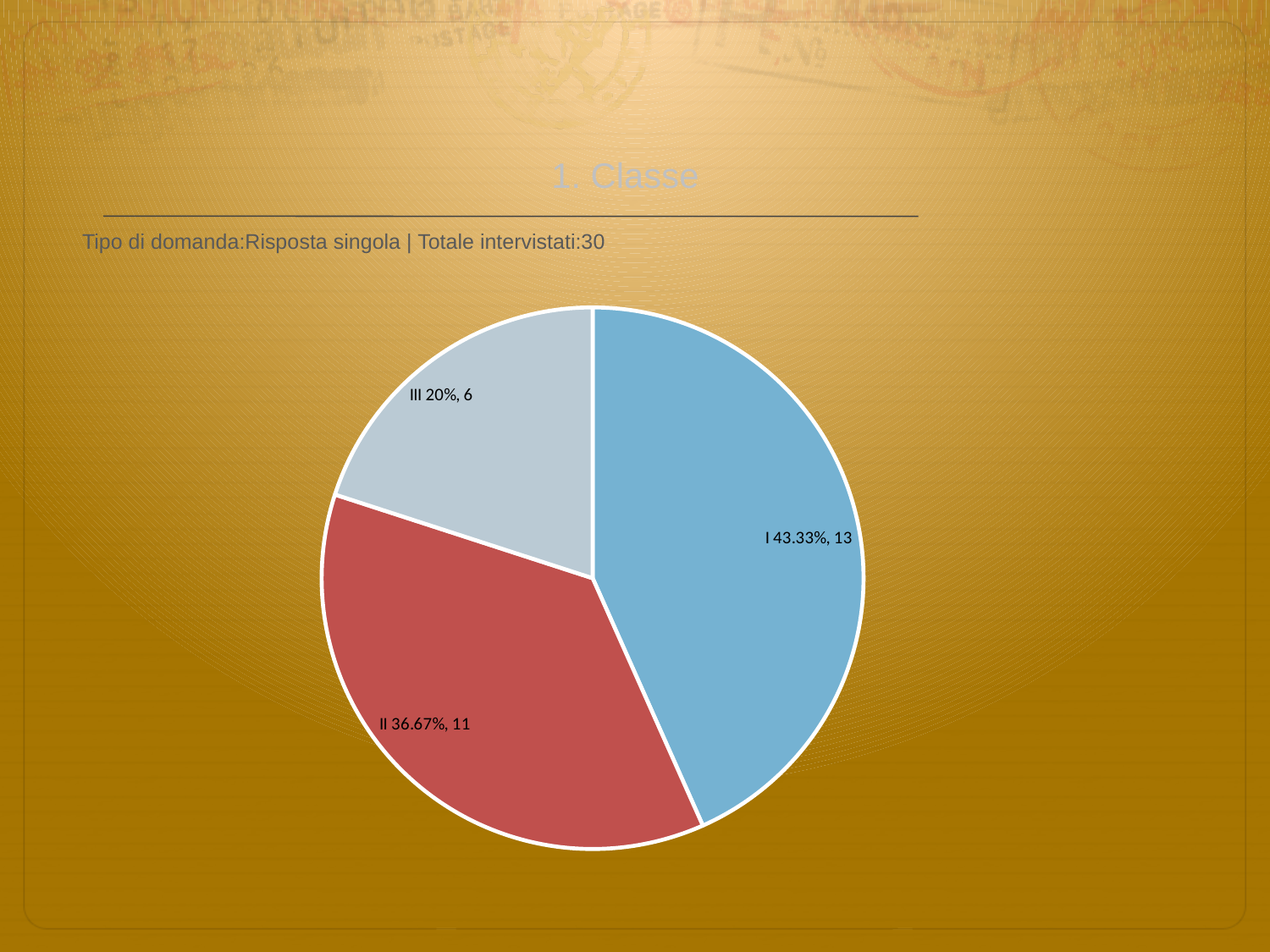
What share of the pie does category I represent? 43.33% What is the count for category I? 13 Which category has the largest slice? I What kind of chart is shown on the slide? pie chart What is the difference in count between category I and category II? 2 How many slices does the pie chart have? 3 Which is larger, the count for category II or category III? II What share of the pie does category III represent? 20% What is the count for category III? 6 What is the count for category II? 11 What is the total number of respondents across all slices? 30 Which category has the smallest slice? III